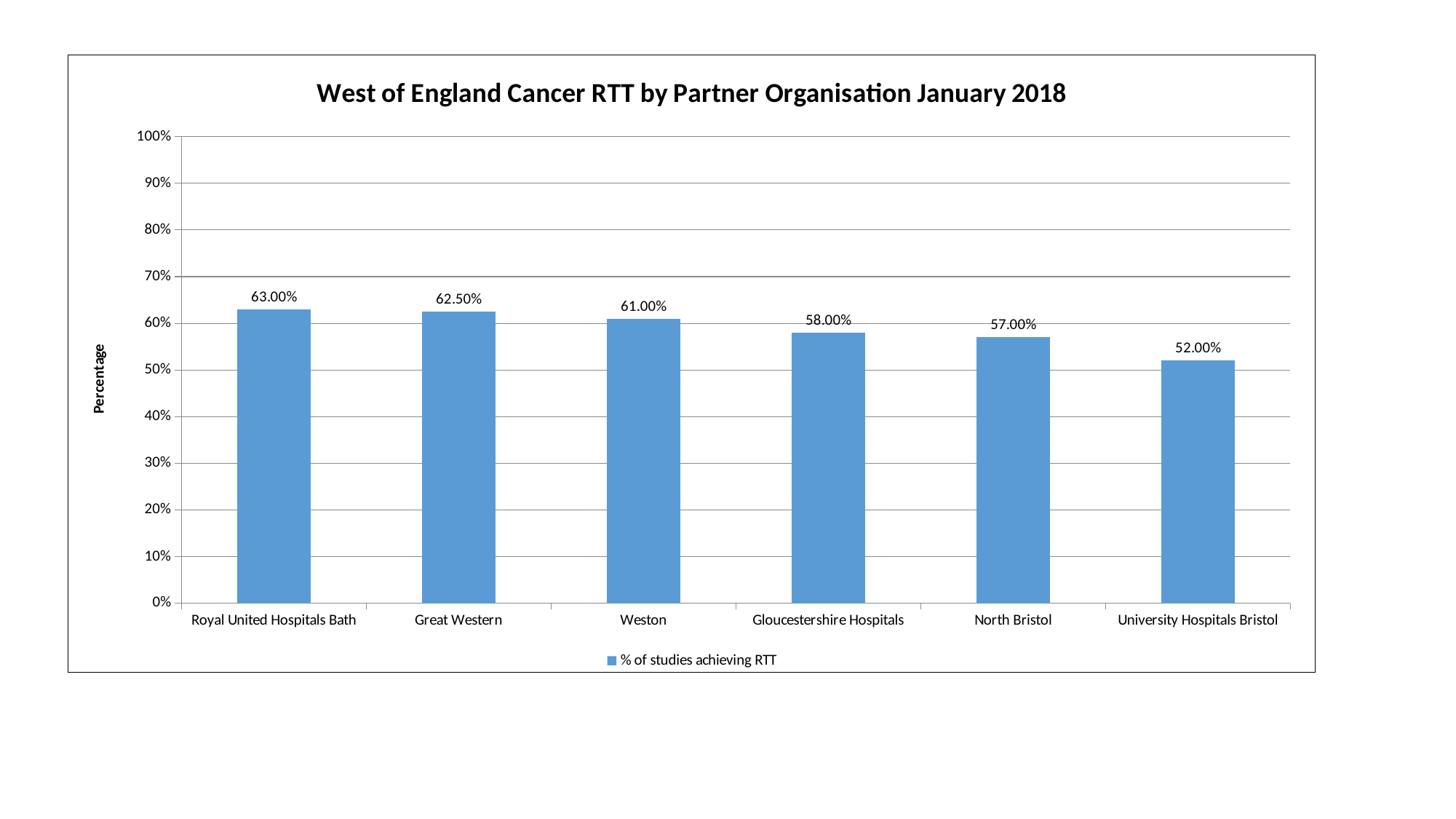
Which is larger, the value for Great Western or the value for Gloucestershire Hospitals? Great Western What is the difference between the values for Royal United Hospitals Bath and University Hospitals Bristol? 11.00% What kind of chart is shown on the slide? Bar chart What is the value for Royal United Hospitals Bath? 63.00% Which organisation has the highest percentage of studies achieving RTT? Royal United Hospitals Bath What is the value for University Hospitals Bristol? 52.00% How many partner organisations are shown on the chart? 6 What is the difference between the values for Weston and North Bristol? 4.00% What is the value for Gloucestershire Hospitals? 58.00% What is the title of the chart? West of England Cancer RTT by Partner Organisation January 2018 Is the value for North Bristol greater or less than 60%? less Which organisation has the lowest percentage of studies achieving RTT? University Hospitals Bristol